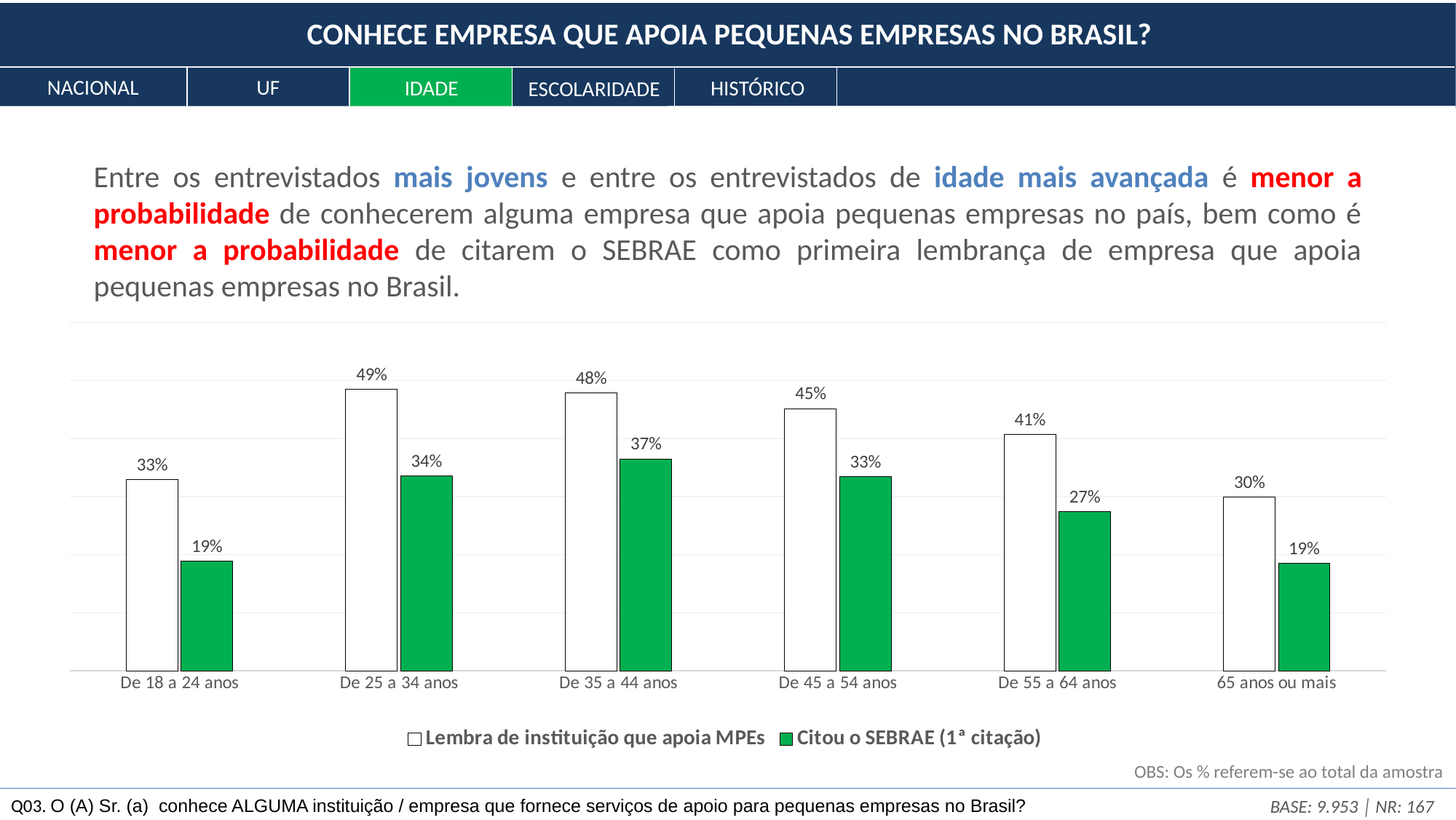
How many age groups are shown on the x axis of the chart? 6 What kind of chart is shown on the slide? Bar chart What is the value of "Lembra de instituição que apoia MPEs" for the "De 25 a 34 anos" age group? 49% What is the value of "Citou o SEBRAE (1ª citação)" for the "De 55 a 64 anos" age group? 27% From "De 25 a 34 anos" to "65 anos ou mais", do the values for "Lembra de instituição que apoia MPEs" rise or fall? Fall What is the difference between "Lembra de instituição que apoia MPEs" and "Citou o SEBRAE (1ª citação)" for the "De 45 a 54 anos" age group? 12% Which colour represents the "Citou o SEBRAE (1ª citação)" series in the chart? Green How many series does the chart legend list? 2 What is the value of "Citou o SEBRAE (1ª citação)" for the "De 35 a 44 anos" age group? 37% Which is larger: "Citou o SEBRAE (1ª citação)" for "De 25 a 34 anos" or for "De 55 a 64 anos"? De 25 a 34 anos Which age group has the highest value for "Lembra de instituição que apoia MPEs"? De 25 a 34 anos Which age group has the lowest value for "Lembra de instituição que apoia MPEs"? 65 anos ou mais